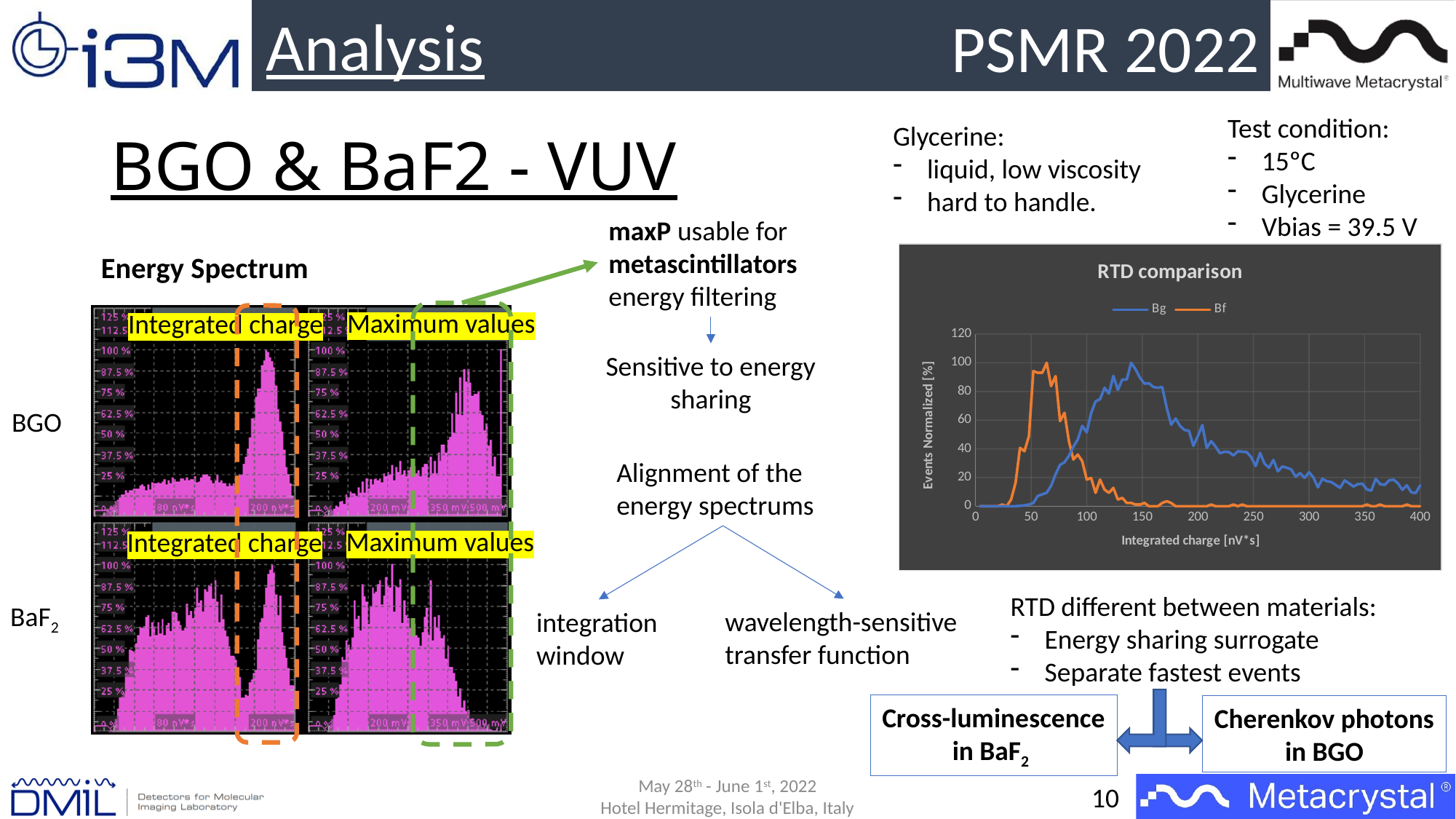
What is the x-axis title of the 'RTD comparison' chart? Integrated charge [nV*s] What are the two series named in the legend of the 'RTD comparison' chart? Bg and Bf In the 'RTD comparison' chart, is the value of the Bg series at an integrated charge of 50 greater or less than 20? less In the 'RTD comparison' chart, which series reaches its peak at a lower integrated charge, Bg or Bf? Bf In the 'RTD comparison' chart, is the value of the Bg series at an integrated charge of 300 greater or less than 60? less How many series does the legend of the 'RTD comparison' chart list? 2 In the 'RTD comparison' chart, which series has the larger value at an integrated charge of 60, Bg or Bf? Bf What kind of chart is the 'RTD comparison' chart? line chart In the 'RTD comparison' chart, does the Bg series rise or fall as the integrated charge increases from 150 to 400? fall In the 'RTD comparison' chart, is the value of the Bf series at an integrated charge of 200 greater or less than 20? less In the 'RTD comparison' chart, which series has the larger value at an integrated charge of 100, Bg or Bf? Bg